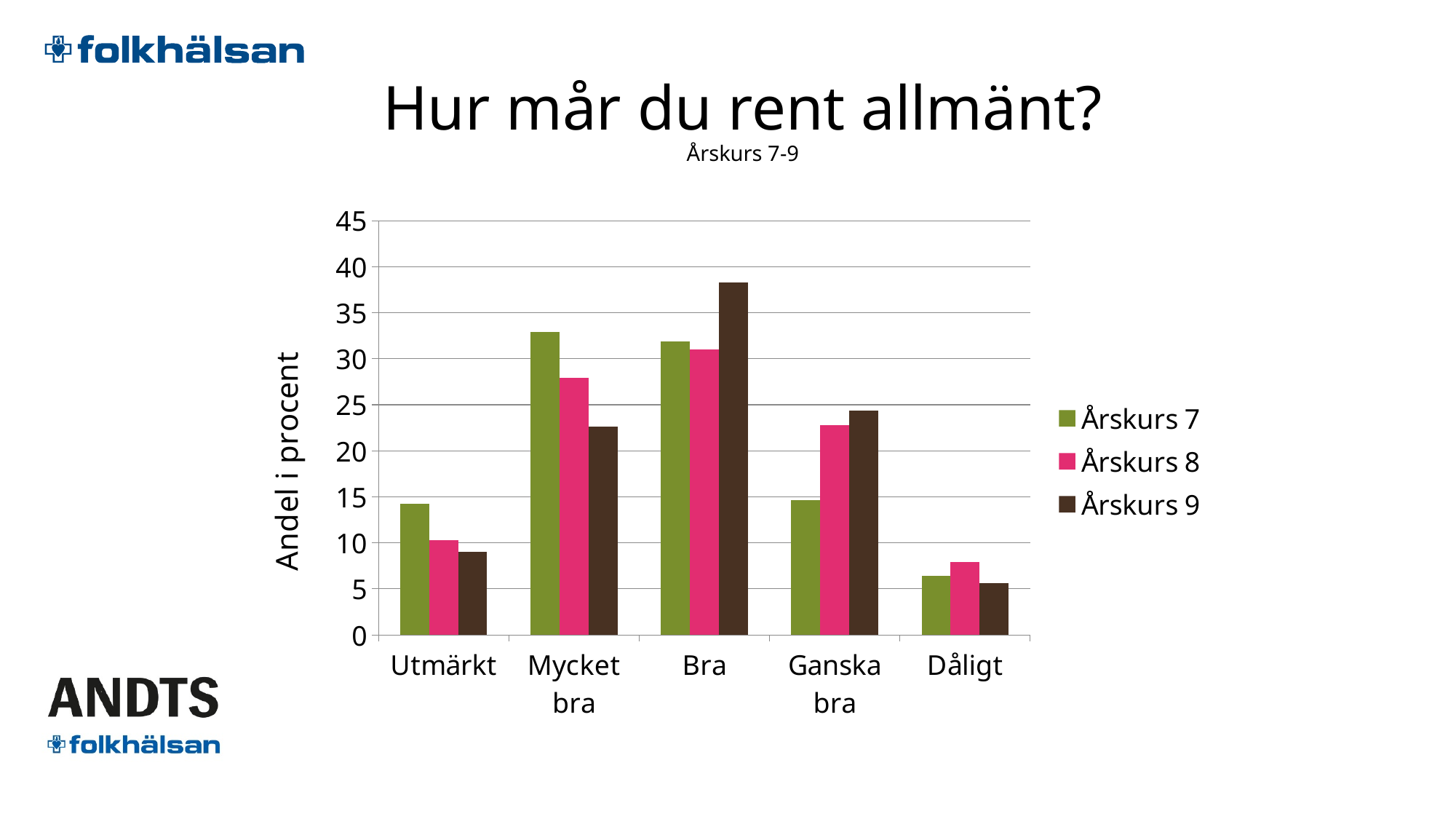
In the Ganska bra category, which is larger: the value for Årskurs 7 or for Årskurs 8? Årskurs 8 How many categories are shown on the x axis of the chart? 5 Is the value for Årskurs 8 in the Dåligt category greater or less than 10? less In the Utmärkt category, which is larger: the value for Årskurs 7 or for Årskurs 9? Årskurs 7 Is the value for Årskurs 9 in the Bra category greater or less than 35? greater For the Årskurs 7 series, which category has the lowest value? Dåligt What is the label on the vertical axis of the chart? Andel i procent Is the value for Årskurs 9 in the Mycket bra category greater or less than 25? less What kind of chart is shown on the slide? bar chart For the Årskurs 9 series, which category has the highest value? Bra For the Årskurs 8 series, which category has the highest value? Bra How many series does the legend list? 3